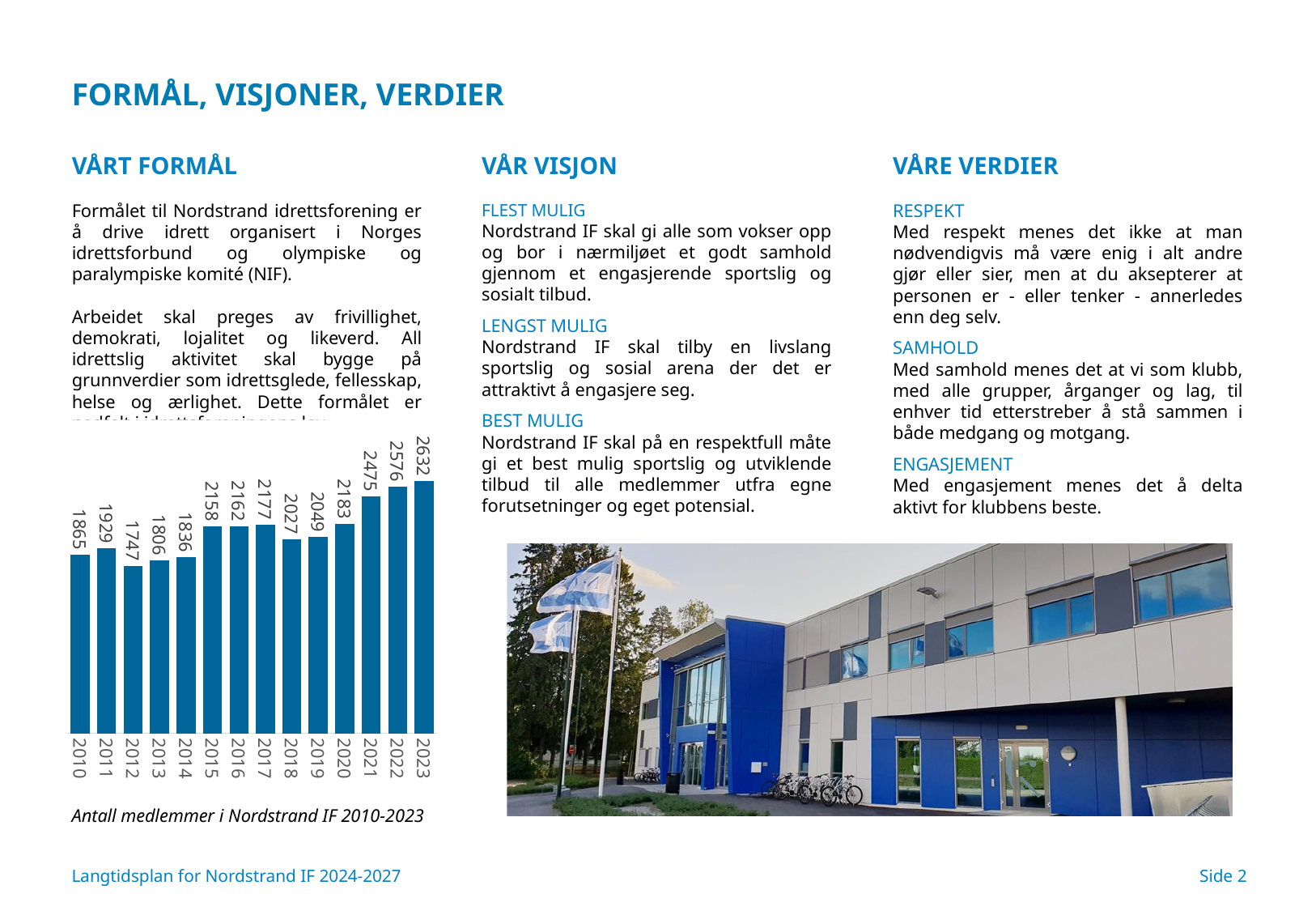
What is the difference between the values for 2022 and 2021? 101 Do the values generally rise or fall from 2019 to 2023? Rise What is the difference between the values for 2023 and 2010? 767 Which is larger, the value for 2017 or the value for 2018? 2017 What is the number of members shown for 2010? 1865 What value is shown for 2018? 2027 Which year has the highest number of members? 2023 How many years are shown in the chart? 14 What is the caption below the chart? Antall medlemmer i Nordstrand IF 2010-2023 Which year has the lowest number of members? 2012 What kind of chart is shown on the slide? Bar chart What is the number of members shown for 2023? 2632